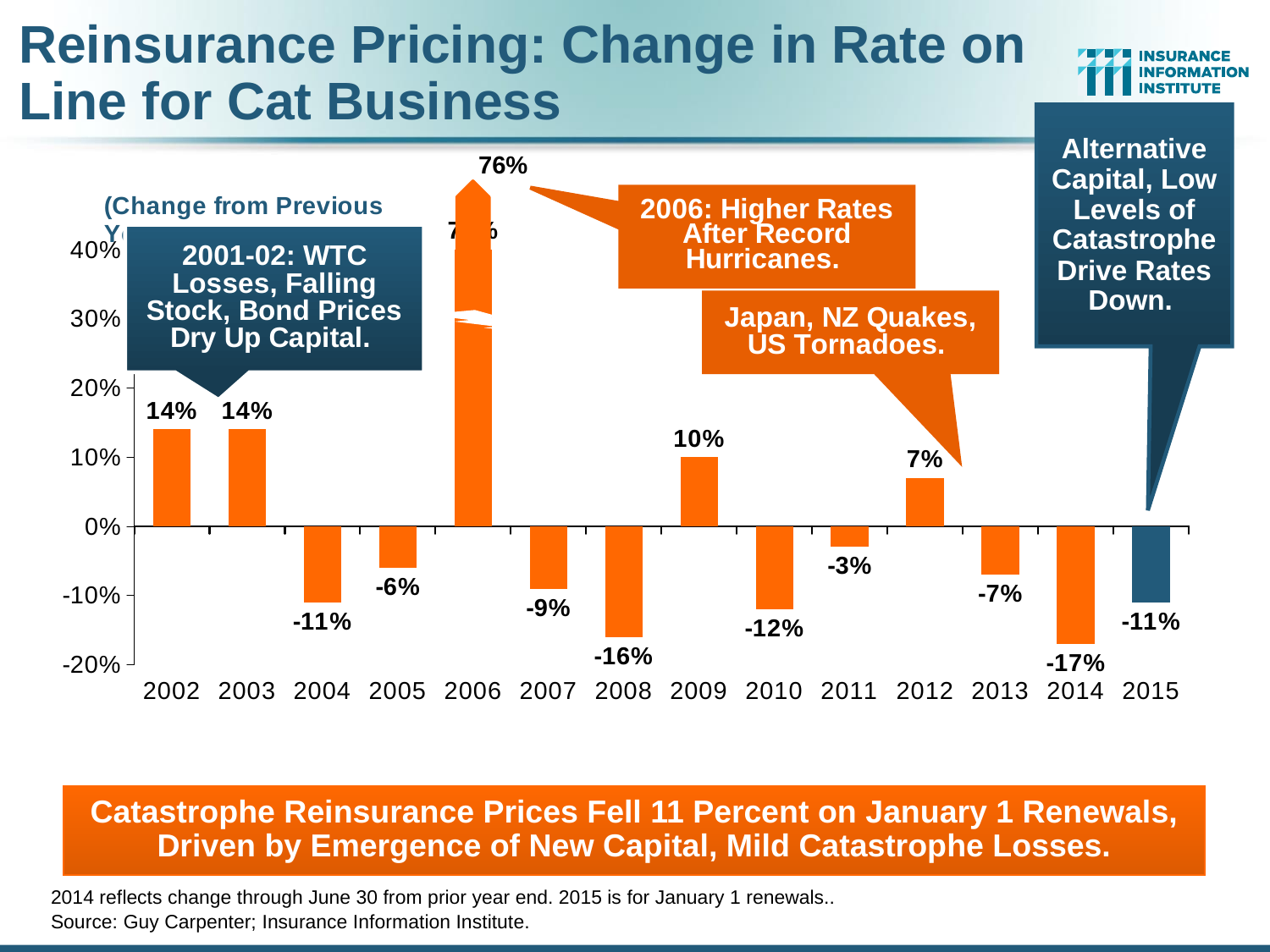
What kind of chart is this? Bar chart How many years are shown on the x axis? 14 What is the change in rate on line for 2006? 76% Is the value for 2008 greater or less than -10%? less Which year has the highest change in rate on line? 2006 What is the value shown for 2010? -12% Which is larger, the value for 2005 or the value for 2011? 2011 What is the value shown for 2009? 10% What is the difference between the values for 2009 and 2012? 3 percentage points What is the value shown for 2014? -17% What is the value shown for 2015? -11% Which year has the lowest change in rate on line? 2014